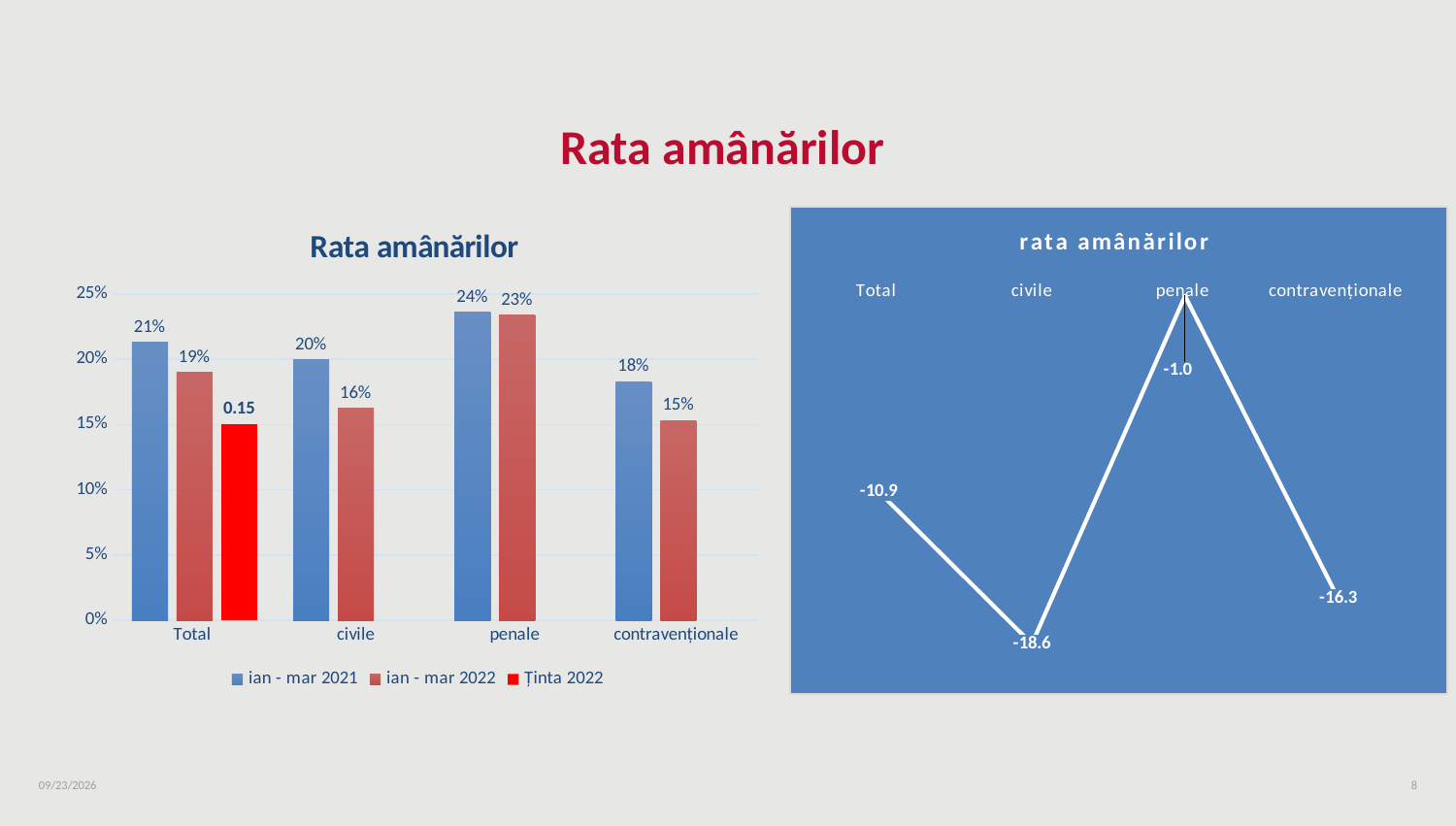
In the left bar chart 'Rata amânărilor', what is the value of the Ținta 2022 bar for Total? 0.15 How many series does the legend of the left bar chart 'Rata amânărilor' list? 3 In the left bar chart 'Rata amânărilor', what is the value for penale in the ian - mar 2021 series? 24% In the right line chart 'rata amânărilor', which category has the highest value? penale In the right line chart 'rata amânărilor', what is the value for civile? -18.6 In the left bar chart 'Rata amânărilor', what is the value for civile in the ian - mar 2022 series? 16% In the left bar chart 'Rata amânărilor', which category has the lowest ian - mar 2021 value? contravenționale In the left bar chart 'Rata amânărilor', which is larger for contravenționale: the ian - mar 2021 value or the ian - mar 2022 value? ian - mar 2021 In the left bar chart 'Rata amânărilor', which category has the highest ian - mar 2022 value? penale In the left bar chart 'Rata amânărilor', what is the difference between the ian - mar 2021 and ian - mar 2022 values for civile? 4% How many categories are shown on the x axis of the right line chart 'rata amânărilor'? 4 What kind of chart is the chart on the right titled 'rata amânărilor'? line chart